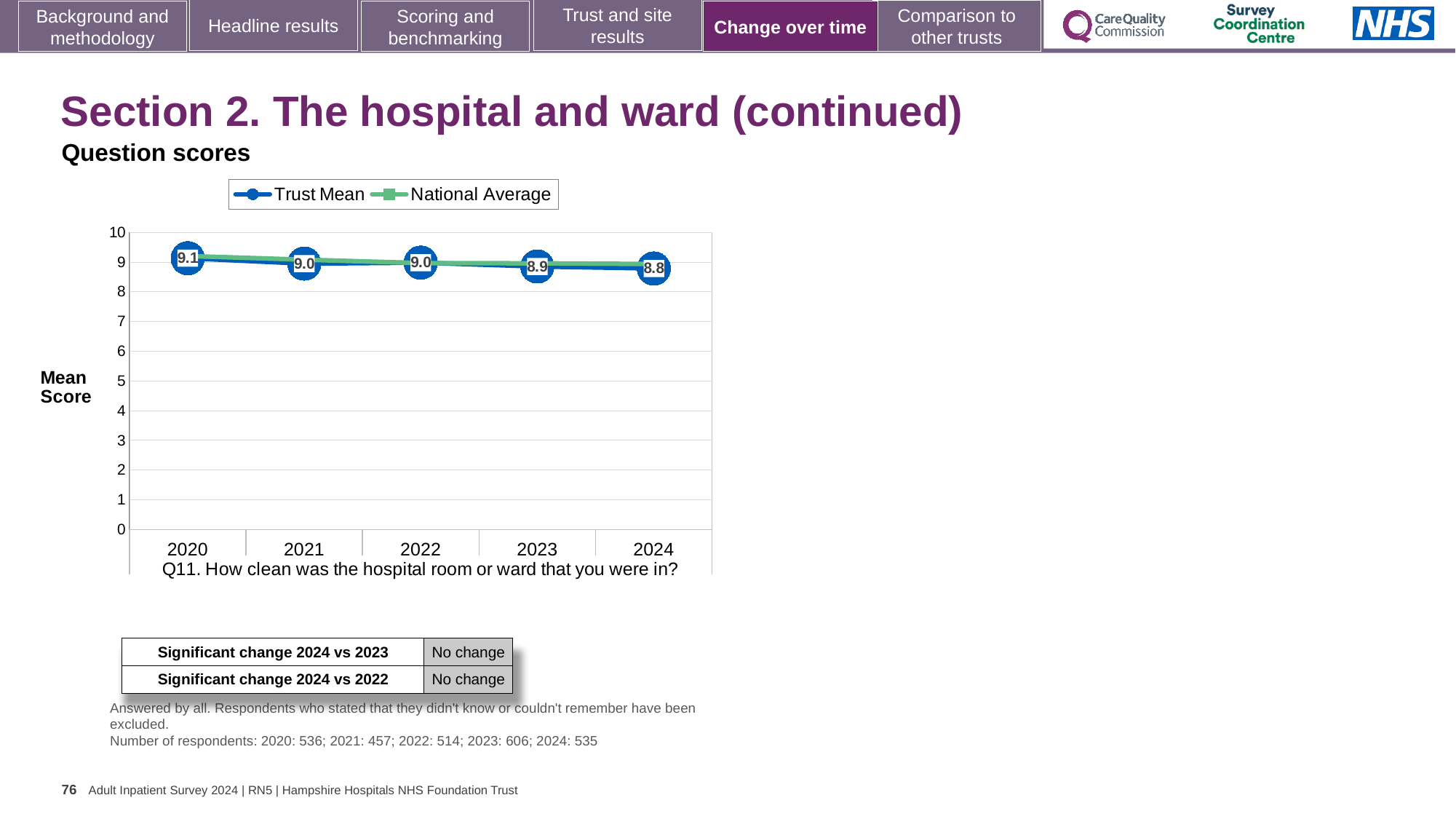
In which year is the Trust Mean lowest? 2024 What kind of chart is shown? Line chart Is the National Average value for 2022 greater or less than 5? greater What is the Trust Mean value for 2023? 8.9 How many years are shown on the x axis? 5 In which year is the Trust Mean highest? 2020 What is the difference between the Trust Mean in 2020 and in 2024? 0.3 What is the Trust Mean value for 2020? 9.1 How many series does the legend list? 2 Does the Trust Mean rise or fall from 2020 to 2024? Fall Which is larger, the Trust Mean for 2020 or for 2024? 2020 What is the Trust Mean value for 2024? 8.8